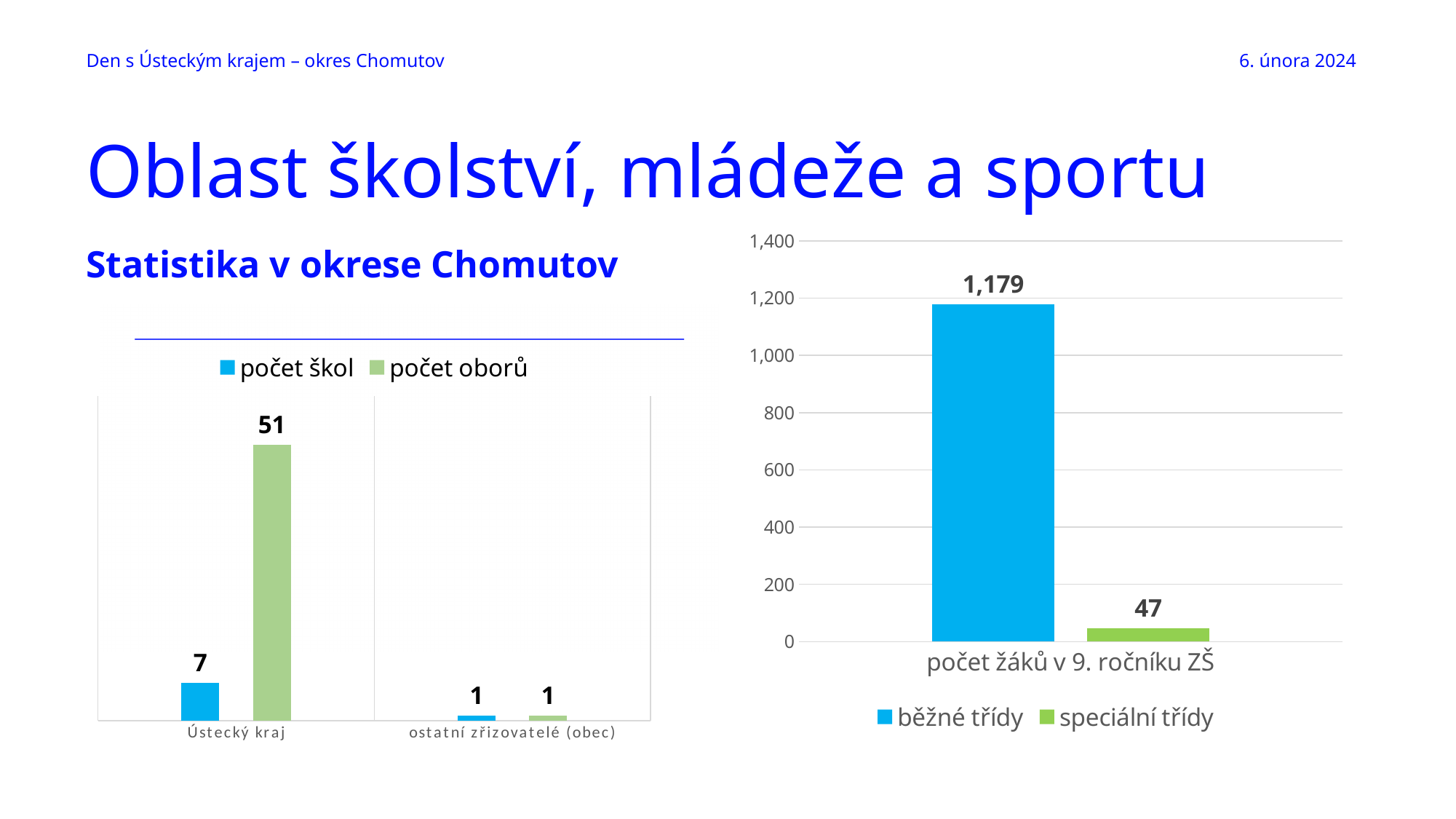
In the left chart, which series has the higher value for Ústecký kraj, počet škol or počet oborů? počet oborů What kind of chart is the right chart? bar chart In the right chart, what is the value for běžné třídy? 1,179 In the left chart, what is the value of počet oborů for Ústecký kraj? 51 In the left chart, what is the value of počet škol for ostatní zřizovatelé (obec)? 1 In the right chart, what is the difference between běžné třídy and speciální třídy? 1,132 In the right chart, is the value for běžné třídy greater or less than 1,000? greater In the left chart, what is the value of počet škol for Ústecký kraj? 7 In the right chart, what is the value for speciální třídy? 47 In the left chart, how many categories are shown on the x axis? 2 In the left chart, how many series does the legend list? 2 In the left chart, what is the difference between počet oborů and počet škol for Ústecký kraj? 44